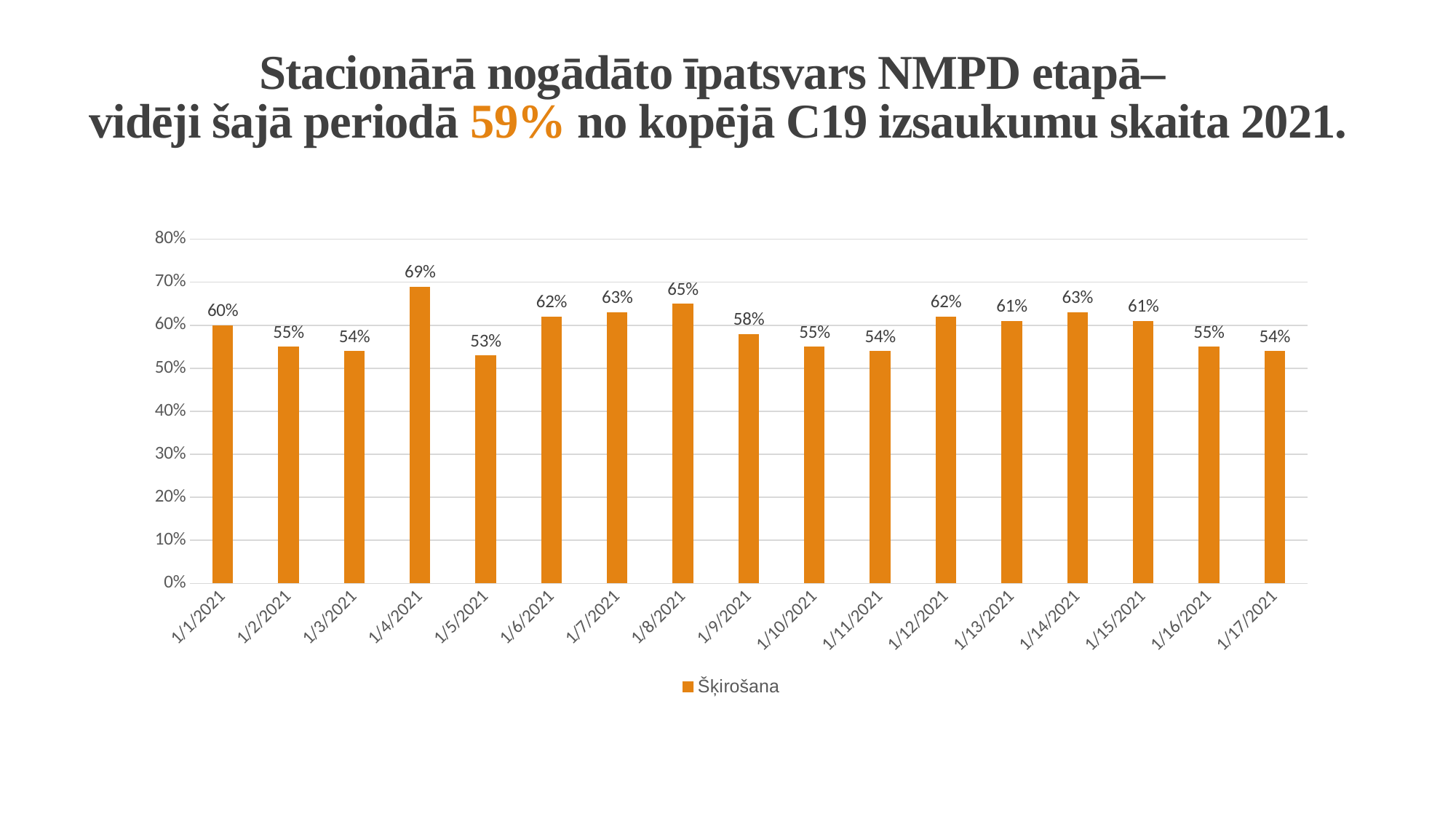
Which is larger, the value for 1/7/2021 or the value for 1/10/2021? 1/7/2021 What kind of chart is shown on the slide? bar chart What is the value for 1/17/2021? 54% What is the value for 1/4/2021? 69% What is the difference between the values for 1/8/2021 and 1/1/2021? 5% Which date has the lowest value? 1/5/2021 Is the value for 1/14/2021 greater or less than 60%? greater Which date has the highest value? 1/4/2021 How many series does the legend list? 1 How many dates are shown on the x axis? 17 What is the value for 1/9/2021? 58% What is the difference between the values for 1/4/2021 and 1/5/2021? 16%